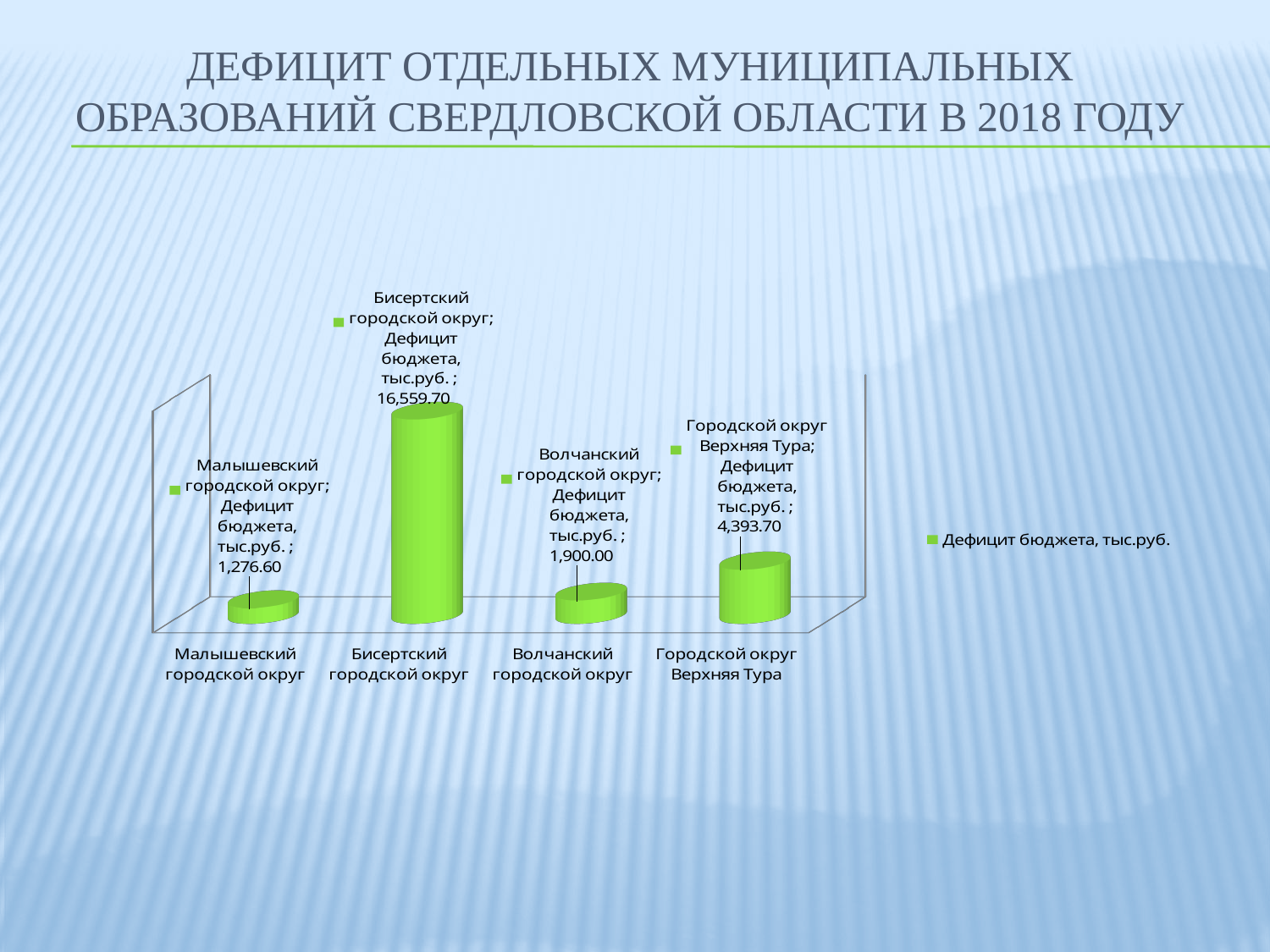
Which municipality has the lowest budget deficit on the chart? Малышевский городской округ How many municipalities are shown on the chart? 4 Which has a larger budget deficit: Волчанский городской округ or Городской округ Верхняя Тура? Городской округ Верхняя Тура Which municipality has the highest budget deficit on the chart? Бисертский городской округ What is the budget deficit value shown for Волчанский городской округ? 1,900.00 What is the budget deficit value shown for Малышевский городской округ? 1,276.60 What type of chart is shown on the slide? Bar chart What is the budget deficit value shown for Городской округ Верхняя Тура? 4,393.70 What is the difference between the budget deficit of Бисертский городской округ and Малышевский городской округ? 15,283.10 What is the budget deficit value shown for Бисертский городской округ? 16,559.70 What is the difference between the budget deficit of Городской округ Верхняя Тура and Волчанский городской округ? 2,493.70 What is the legend entry shown on the chart? Дефицит бюджета, тыс.руб.